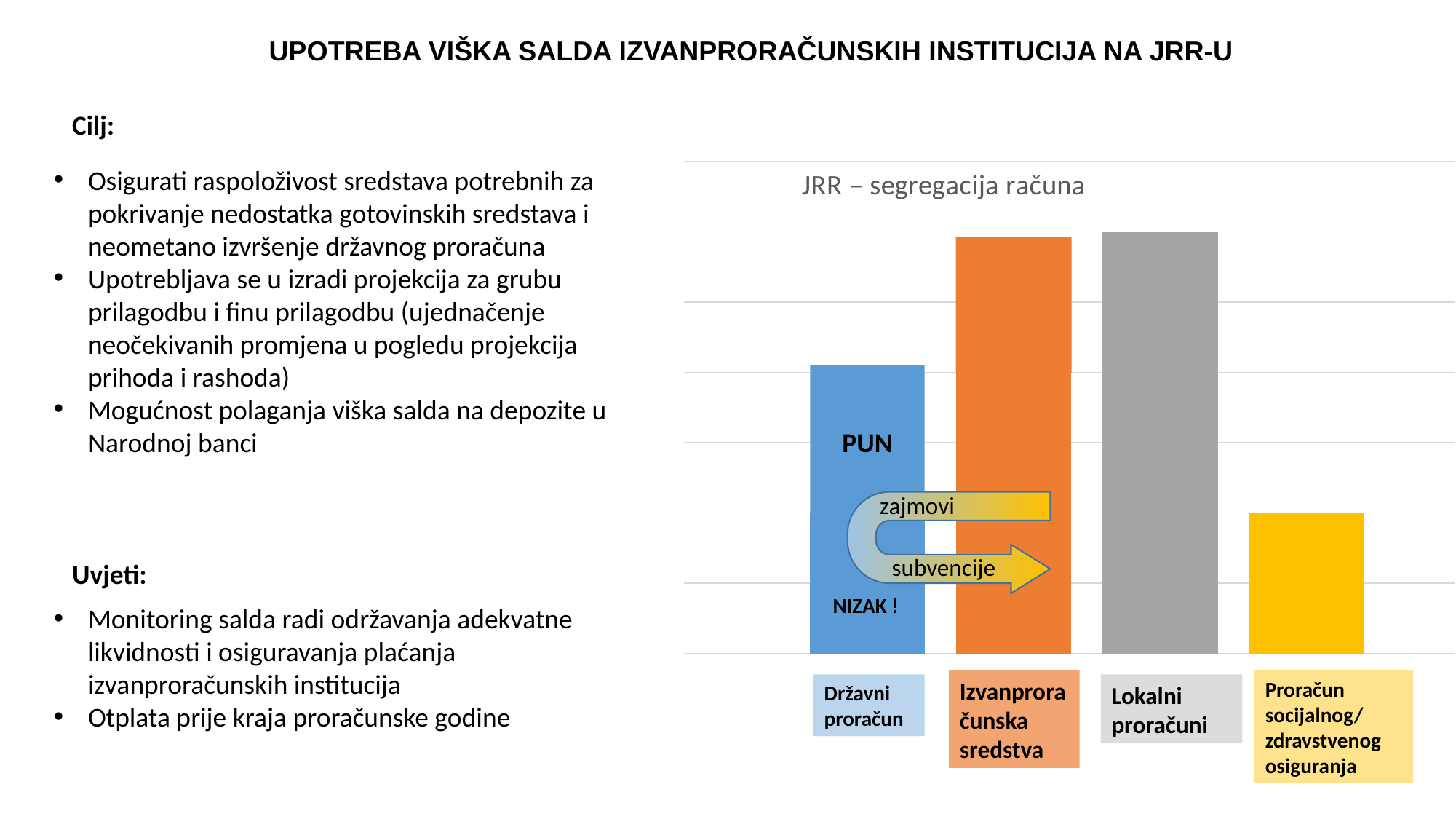
Which bar is taller: Lokalni proračuni or Državni proračun? Lokalni proračuni Which bar is taller: Državni proračun or Proračun socijalnog/zdravstvenog osiguranja? Državni proračun Which bar is taller: Lokalni proračuni or Proračun socijalnog/zdravstvenog osiguranja? Lokalni proračuni How many categories (bars) does the chart show? 4 What is the title of the chart? JRR – segregacija računa Which category has the lowest bar in the chart? Proračun socijalnog/zdravstvenog osiguranja What colour is the bar for Državni proračun? blue What kind of chart is shown on the slide? bar chart